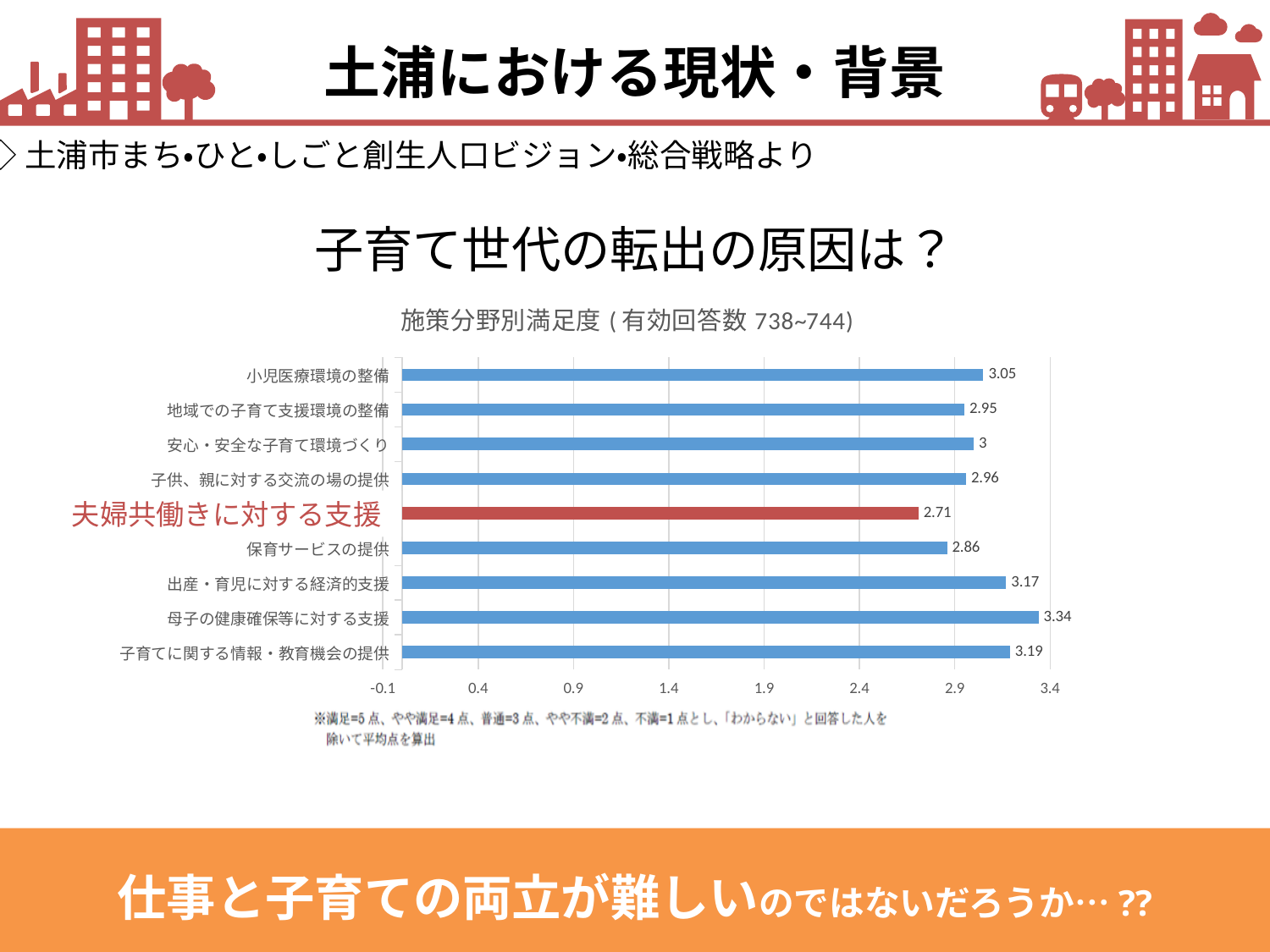
What is the satisfaction score for 母子の健康確保等に対する支援? 3.34 How many categories are shown in the bar chart? 9 Which category has the lowest satisfaction score? 夫婦共働きに対する支援 What is the satisfaction score for 夫婦共働きに対する支援? 2.71 Which has a higher score, 出産・育児に対する経済的支援 or 子育てに関する情報・教育機会の提供? 子育てに関する情報・教育機会の提供 What is the satisfaction score for 保育サービスの提供? 2.86 What is the title of the chart? 施策分野別満足度 ( 有効回答数 738~744) Which category has the highest satisfaction score? 母子の健康確保等に対する支援 Which category's bar is highlighted in red? 夫婦共働きに対する支援 What is the difference between the scores for 母子の健康確保等に対する支援 and 夫婦共働きに対する支援? 0.63 What type of chart is shown on the slide? Bar chart What is the satisfaction score for 小児医療環境の整備? 3.05